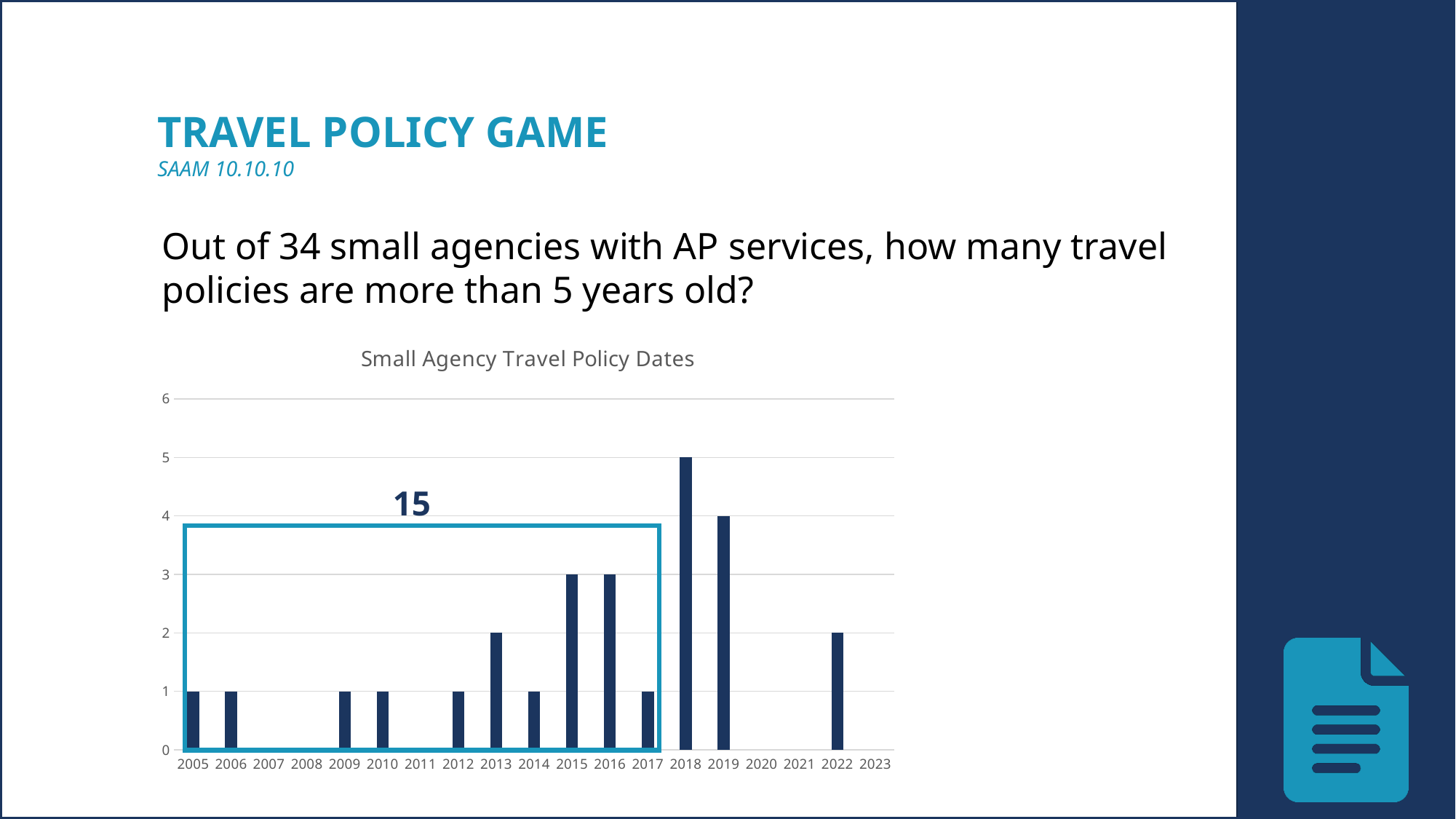
What is the value for 2015? 3 What kind of chart is shown on the slide? bar chart What is the value for 2019? 4 Which is larger, the value for 2013 or the value for 2016? 2016 What number is printed above the highlighted box covering 2005 to 2017? 15 How many years are labelled on the x axis of the chart? 19 What is the difference between the values for 2018 and 2019? 1 Which year has the highest bar in the chart? 2018 What is the title of the chart? Small Agency Travel Policy Dates Is the value for 2018 greater or less than 4? greater What is the value for 2018? 5 What is the value for 2022? 2